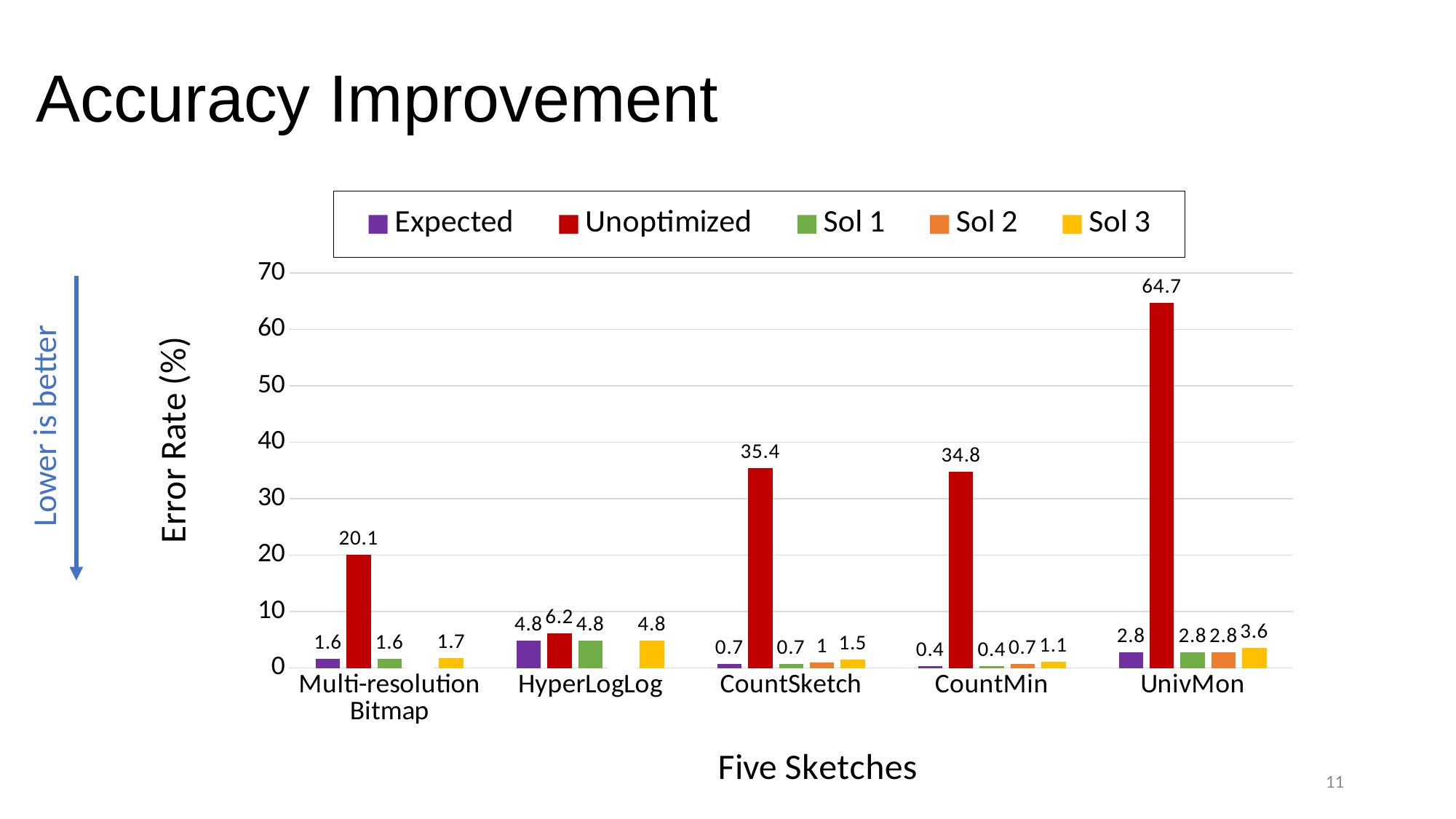
What is the Sol 3 error rate for CountMin? 1.1 Which is larger, the Unoptimized error rate for CountSketch or for CountMin? CountSketch What is the difference between the Unoptimized and Expected error rates for Multi-resolution Bitmap? 18.5 What is the Expected error rate for HyperLogLog? 4.8 What is the Unoptimized error rate for UnivMon? 64.7 How many series does the legend list? 5 How many sketches are shown on the x axis? 5 Which sketch has the highest Unoptimized error rate? UnivMon What kind of chart is shown on the slide? Bar chart Is the Unoptimized error rate for UnivMon greater or less than 60? greater Which sketch has the lowest Unoptimized error rate? HyperLogLog What is the Unoptimized error rate for CountSketch? 35.4